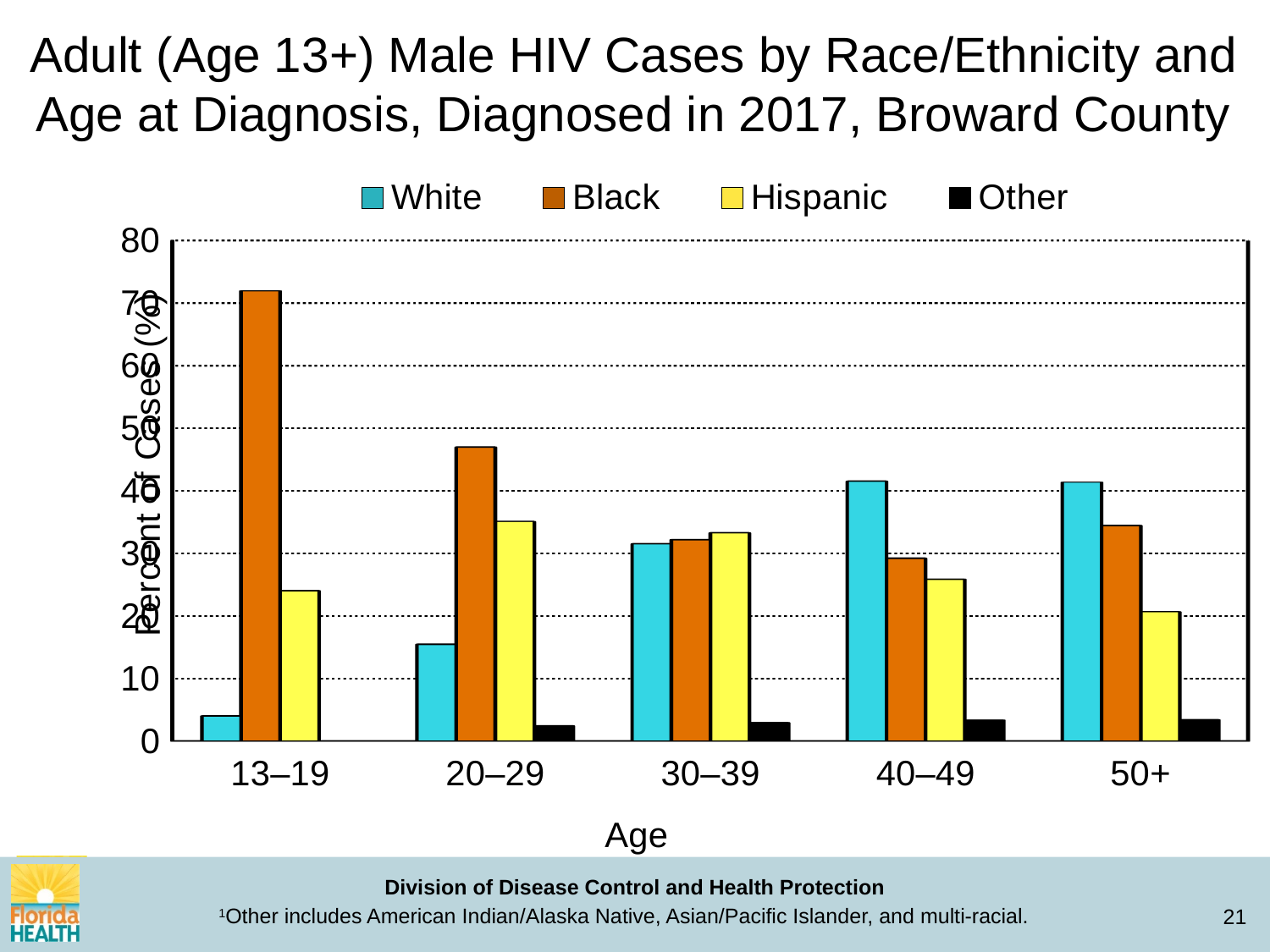
What kind of chart is shown on the slide? bar chart Which age group has the lowest value for White? 13–19 Which age group has the highest value for Black? 13–19 Is the value for Hispanic in the 20–29 age group greater or less than 30? greater Is the value for White in the 13–19 age group greater or less than 10? less Is the value for Black in the 13–19 age group greater or less than 60? greater How many series does the legend list? 4 Do the values for White rise or fall from the 13–19 age group to the 40–49 age group? rise In the 40–49 age group, which is larger, the value for White or the value for Black? White How many age groups are shown on the x axis? 5 What is the title of the x axis? Age In the 20–29 age group, which is larger, the value for Black or the value for Hispanic? Black